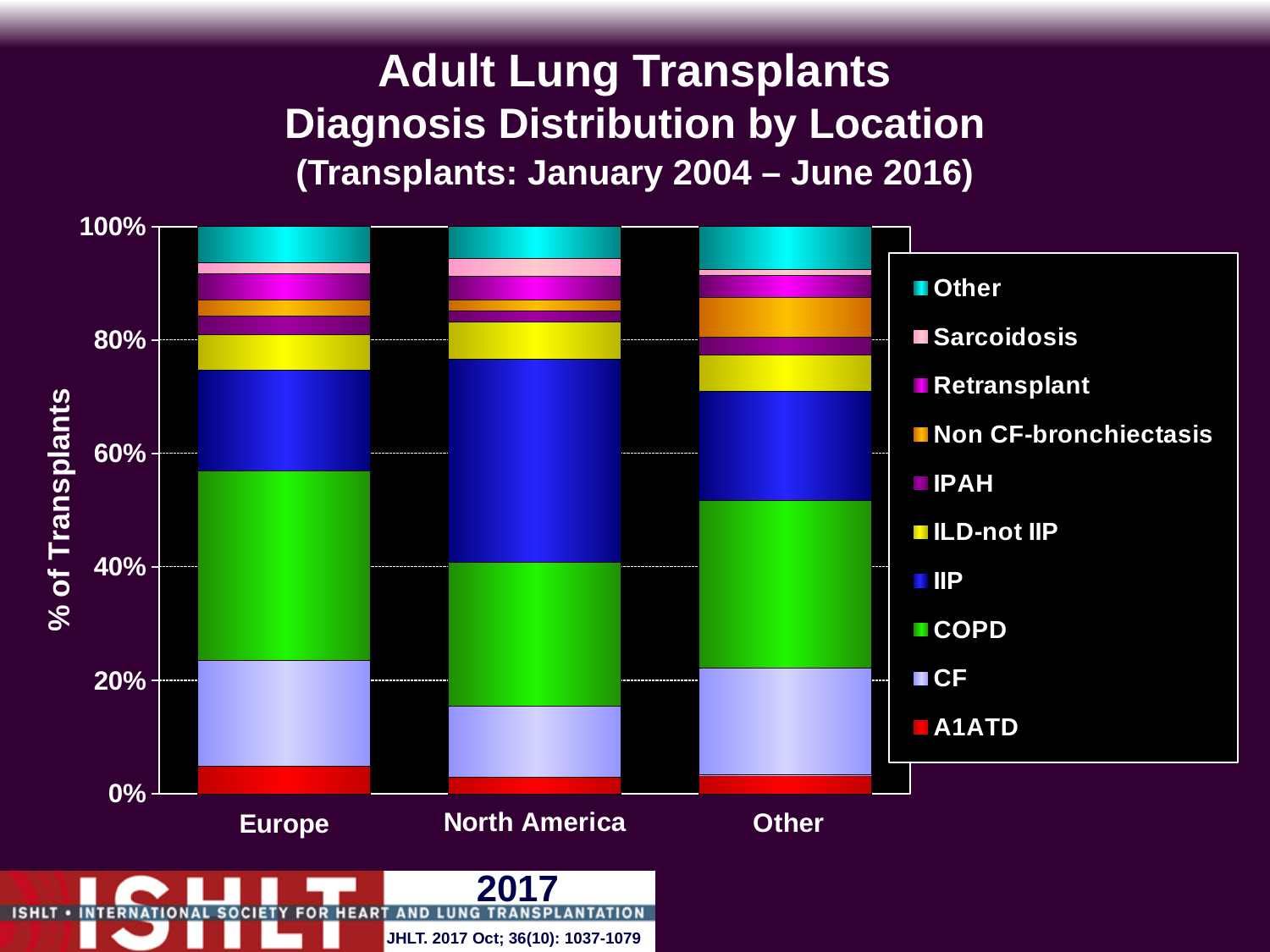
What is the label of the y axis? % of Transplants What kind of chart is shown on the slide? Stacked bar chart Is the COPD segment larger for Europe or for North America? Europe What transplant date range is given in the chart title? January 2004 – June 2016 What does each stacked bar total? 100% Is the combined share of A1ATD and CF in North America greater or less than 20%? less Which location has the smallest CF segment? North America How many diagnosis categories does the legend list? 10 Which location has the largest IIP segment? North America Is the combined share of A1ATD and CF in Europe greater or less than 20%? greater How many locations (bars) are shown on the x axis? 3 Which location has the largest Non CF-bronchiectasis segment? Other